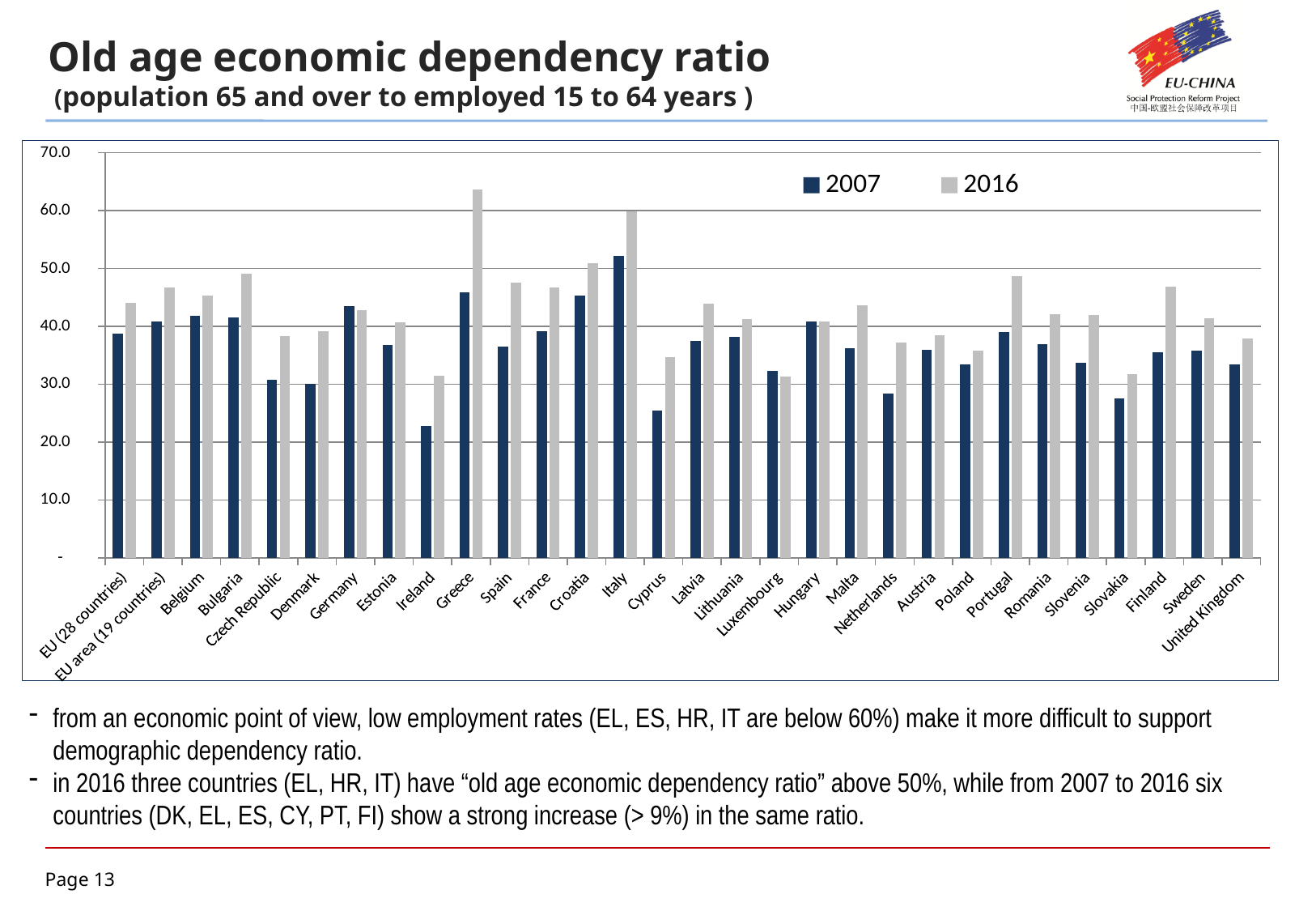
Which country has the highest value for 2016? Greece Which country has the highest value for 2007? Italy How many series does the legend list? 2 Which years are listed in the chart legend? 2007 and 2016 For Portugal, which is larger: the 2007 value or the 2016 value? 2016 What kind of chart is shown on the slide? bar chart Which country has the lowest value for 2007? Ireland Which is larger for 2016: Belgium or Bulgaria? Bulgaria Is the 2016 value for Greece greater or less than 60.0? greater Is the 2007 value for Italy greater or less than 50.0? greater How many countries or regions are shown on the x axis of the chart? 30 Is the 2007 value for Ireland greater or less than 30.0? less